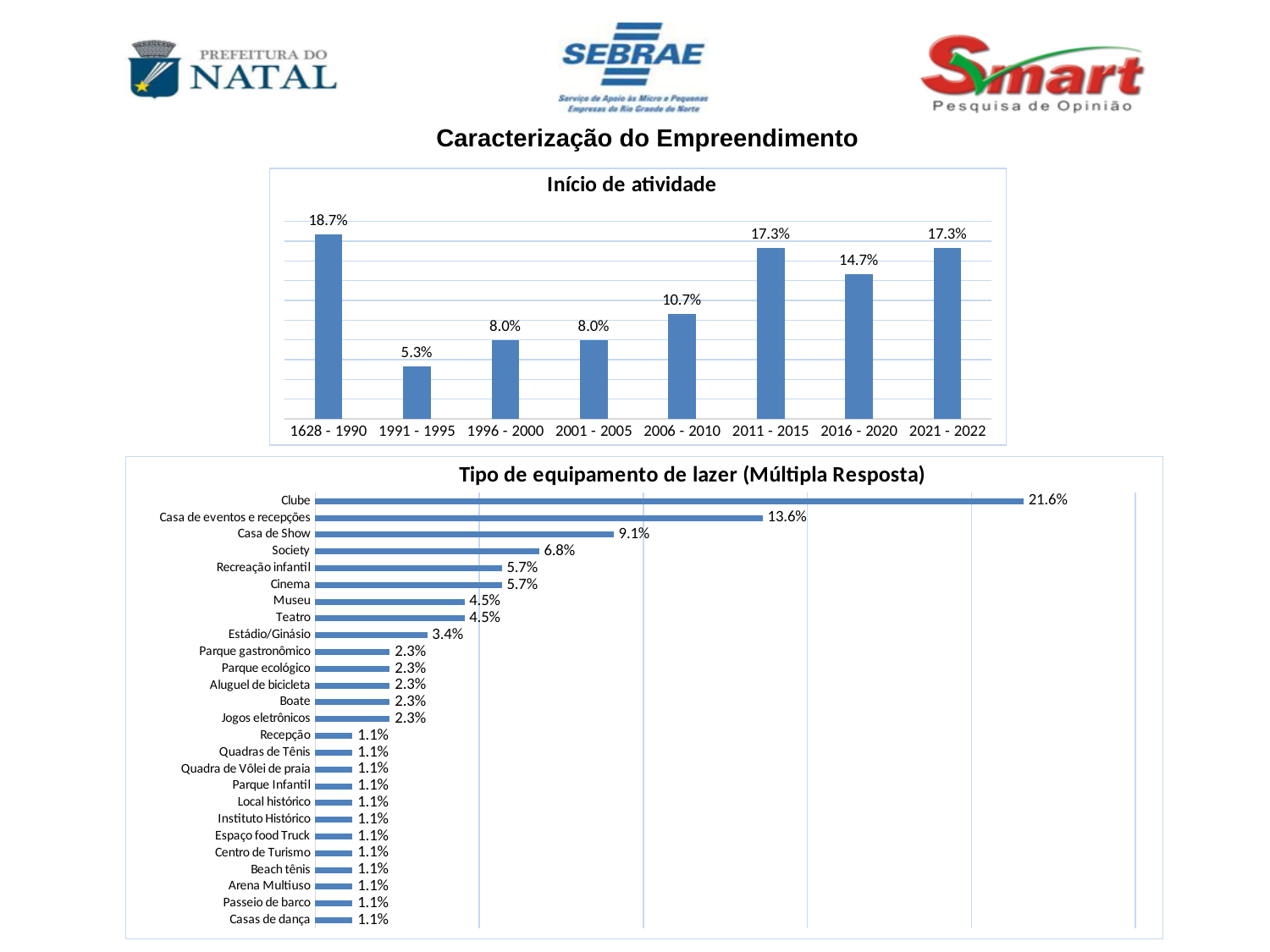
In the 'Início de atividade' chart, what is the value for 1628 - 1990? 18.7% In the 'Início de atividade' chart, what is the difference between the values for 2011 - 2015 and 2016 - 2020? 2.6% In the 'Início de atividade' chart, which period has the lowest value? 1991 - 1995 In the 'Tipo de equipamento de lazer (Múltipla Resposta)' chart, what is the value for Estádio/Ginásio? 3.4% In the 'Início de atividade' chart, how many periods are shown on the x axis? 8 In the 'Tipo de equipamento de lazer (Múltipla Resposta)' chart, what is the difference between the values for Clube and Casa de eventos e recepções? 8.0% In the 'Tipo de equipamento de lazer (Múltipla Resposta)' chart, what is the value for Casa de Show? 9.1% In the 'Início de atividade' chart, which is larger: the value for 2006 - 2010 or the value for 2001 - 2005? 2006 - 2010 What is the title of the lower chart on the slide? Tipo de equipamento de lazer (Múltipla Resposta) In the 'Tipo de equipamento de lazer (Múltipla Resposta)' chart, how many categories are listed? 26 In the 'Tipo de equipamento de lazer (Múltipla Resposta)' chart, which category has the highest value? Clube What kind of chart is 'Início de atividade'? Bar chart